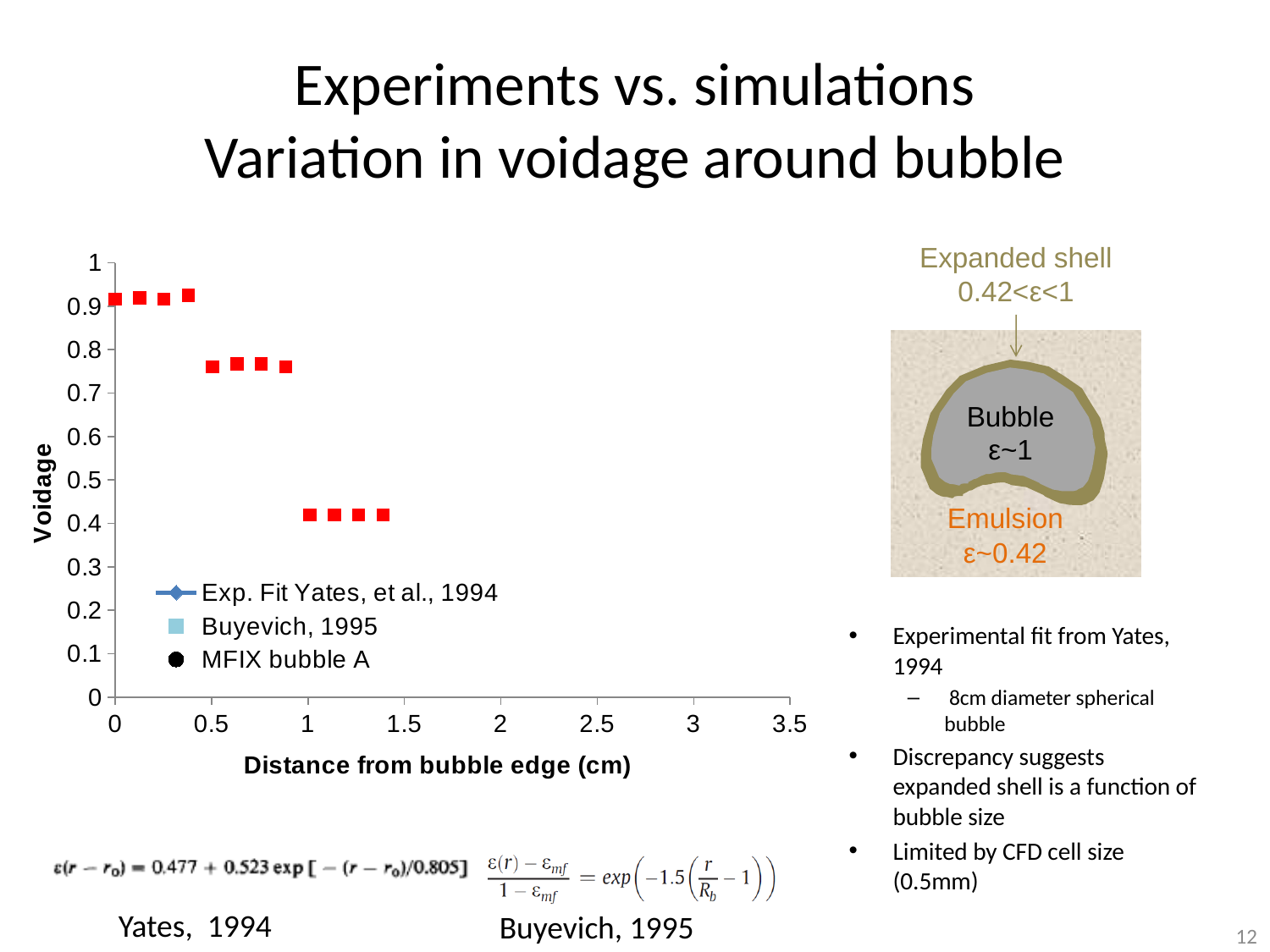
Is the plotted voidage at a distance of 0.5 cm greater or less than 0.8? less What kind of chart is shown on the slide? scatter chart Do the plotted voidage values rise or fall as distance from the bubble edge increases? fall What is the label of the chart's x axis? Distance from bubble edge (cm) How many data points are plotted on the chart? 12 Is the plotted voidage at a distance of 0 cm greater or less than 0.8? greater What is the label of the chart's y axis? Voidage Is the plotted voidage at a distance of 1 cm greater or less than 0.5? less How many series does the chart legend list? 3 Which has the larger plotted voidage: the point at 0 cm or the point at 1.4 cm? the point at 0 cm What is the highest value shown on the chart's x axis? 3.5